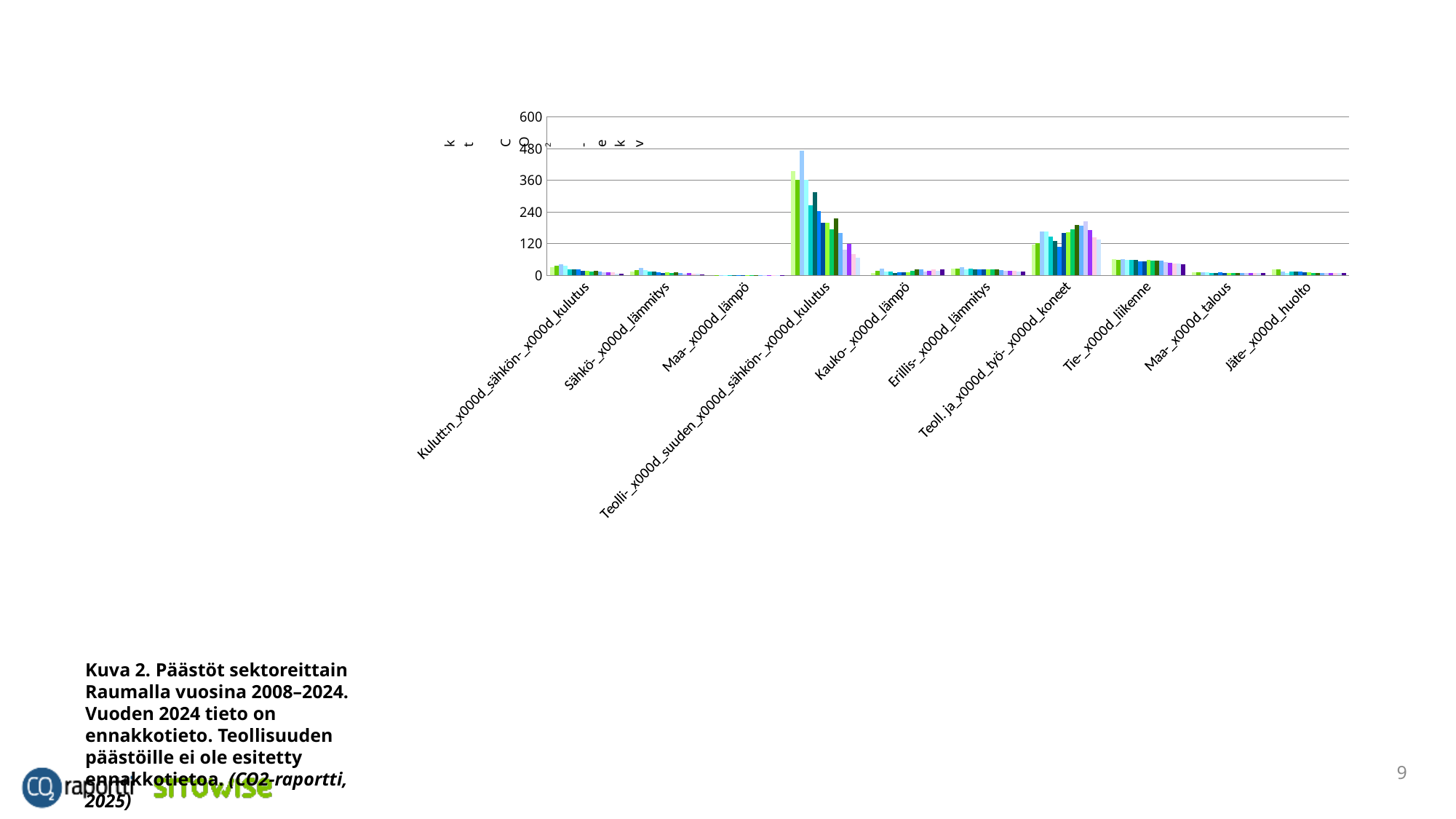
According to the caption, which years does the chart cover? 2008–2024 Which group has taller bars: Teoll. ja_x000d_työ-_x000d_koneet or Tie-_x000d_liikenne? Teoll. ja_x000d_työ-_x000d_koneet What is the highest tick value shown on the y axis of the chart? 600 Which category contains the tallest bar in the chart? Teolli-_x000d_suuden_x000d_sähkön-_x000d_kulutus What kind of chart is shown on the slide? bar chart Which category has the smallest bars in the chart? Maa-_x000d_lämpö How many sector categories are shown along the x axis of the chart? 10 Is the tallest bar in the Teoll. ja_x000d_työ-_x000d_koneet group greater or less than 240? less Are the bars in the Tie-_x000d_liikenne group greater or less than 120? less Within the Teolli-_x000d_suuden_x000d_sähkön-_x000d_kulutus group, do the bars generally rise or fall from left to right? fall Is the tallest bar in the Teolli-_x000d_suuden_x000d_sähkön-_x000d_kulutus group greater or less than 360? greater